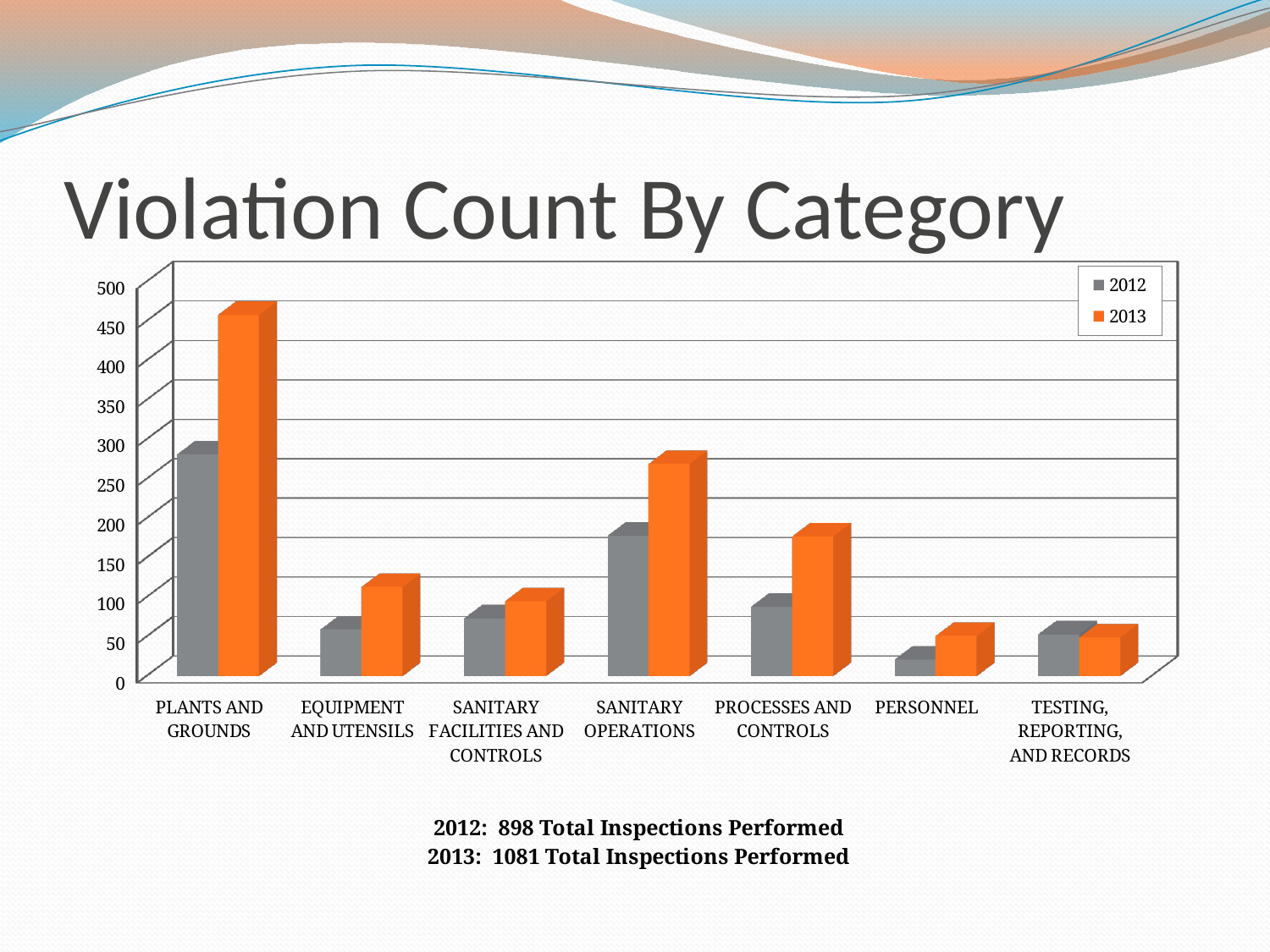
How many series does the legend list? 2 Is the 2012 value for Personnel greater or less than 50? less What kind of chart is shown on the slide? Bar chart How many categories are shown on the x axis? 7 Which category has the lowest 2012 value? Personnel Which colour represents the 2013 series in the legend? Orange What is the title of the chart? Violation Count By Category Which is larger: the 2013 value for Sanitary Operations or the 2013 value for Processes and Controls? Sanitary Operations Is the 2013 value for Sanitary Operations greater or less than 250? greater Is the 2013 value for Plants and Grounds greater or less than 400? greater Which category has the highest 2013 value? Plants and Grounds